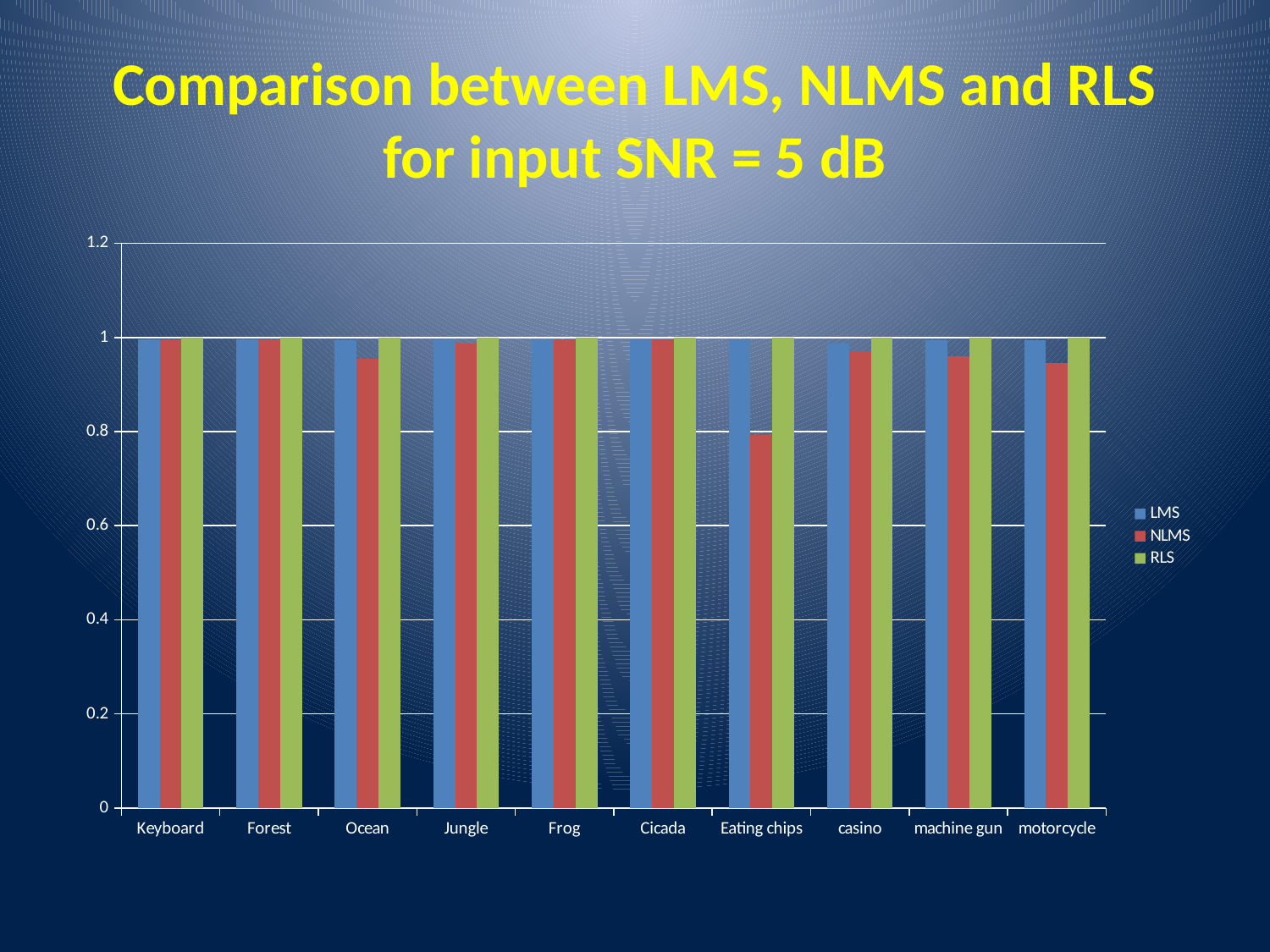
Which is larger for Eating chips, the NLMS value or the RLS value? RLS Is the NLMS value for Ocean greater or less than 0.8? greater Which is larger, the NLMS value for Ocean or the NLMS value for Eating chips? Ocean Which series is shown in green in the legend? RLS Which category has the lowest NLMS value? Eating chips Is the NLMS value for motorcycle greater or less than 0.8? greater Is the LMS value for Keyboard greater or less than 0.8? greater What is the title of the chart on the slide? Comparison between LMS, NLMS and RLS for input SNR = 5 dB How many series does the legend list? 3 What kind of chart is shown on the slide? bar chart How many categories are shown on the x axis? 10